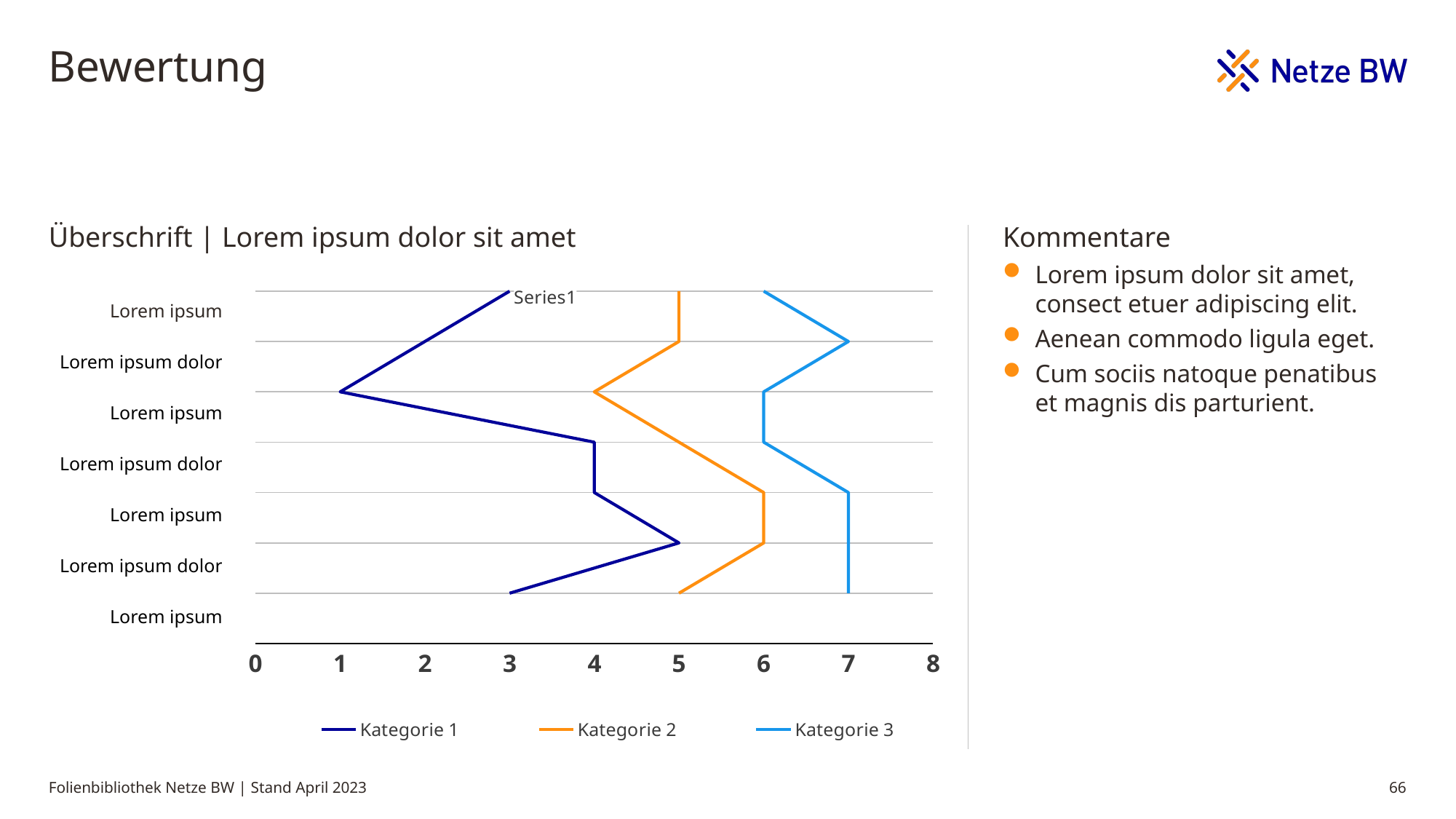
What is the highest value reached by the Kategorie 1 line? 5 What is the largest value shown on the horizontal axis? 8 What kind of chart is shown on the slide? line chart What are the names of the series in the chart legend? Kategorie 1, Kategorie 2, Kategorie 3 What is the title shown above the chart? Überschrift | Lorem ipsum dolor sit amet What is the lowest value reached by the Kategorie 1 line? 1 How many series does the chart legend list? 3 What is the value of Kategorie 3 at the bottom gridline of the chart? 7 What is the lowest value reached by the Kategorie 2 line? 4 At the topmost gridline, which is larger: Kategorie 1 or Kategorie 3? Kategorie 3 What is the highest value reached by the Kategorie 3 line? 7 What is the value of Kategorie 1 at the topmost gridline of the chart? 3